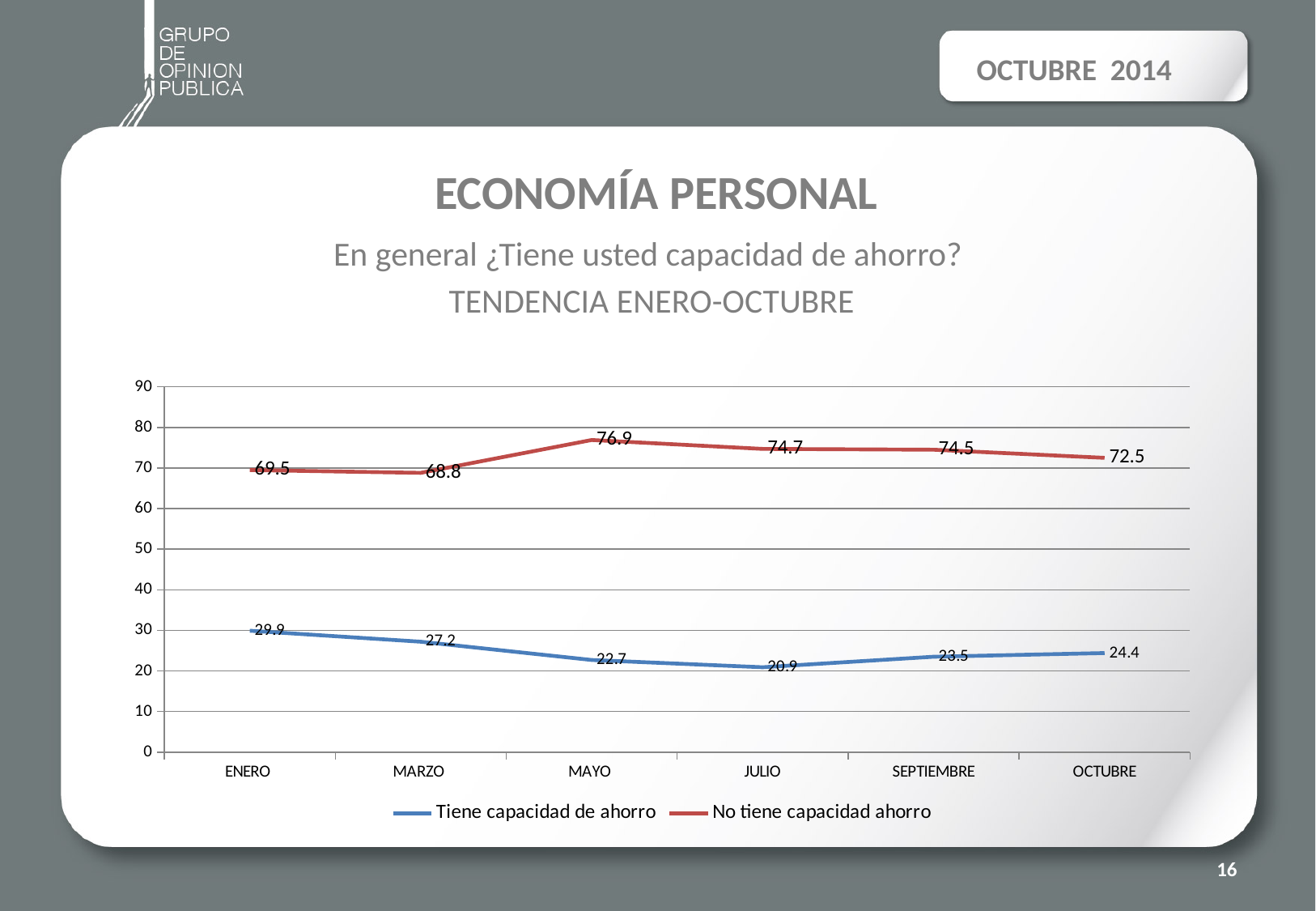
How many series does the legend list? 2 What is the value for "Tiene capacidad de ahorro" in OCTUBRE? 24.4 Does "Tiene capacidad de ahorro" rise or fall from ENERO to JULIO? fall How many months are shown on the x axis? 6 What is the value for "No tiene capacidad ahorro" in MAYO? 76.9 What is the value for "Tiene capacidad de ahorro" in ENERO? 29.9 In which month is "Tiene capacidad de ahorro" lowest? JULIO In which month is "No tiene capacidad ahorro" highest? MAYO Which is larger for "Tiene capacidad de ahorro": ENERO or MARZO? ENERO What kind of chart is shown on the slide? line chart What is the difference between "No tiene capacidad ahorro" and "Tiene capacidad de ahorro" in OCTUBRE? 48.1 Is the value for "No tiene capacidad ahorro" in MARZO greater or less than 70? less